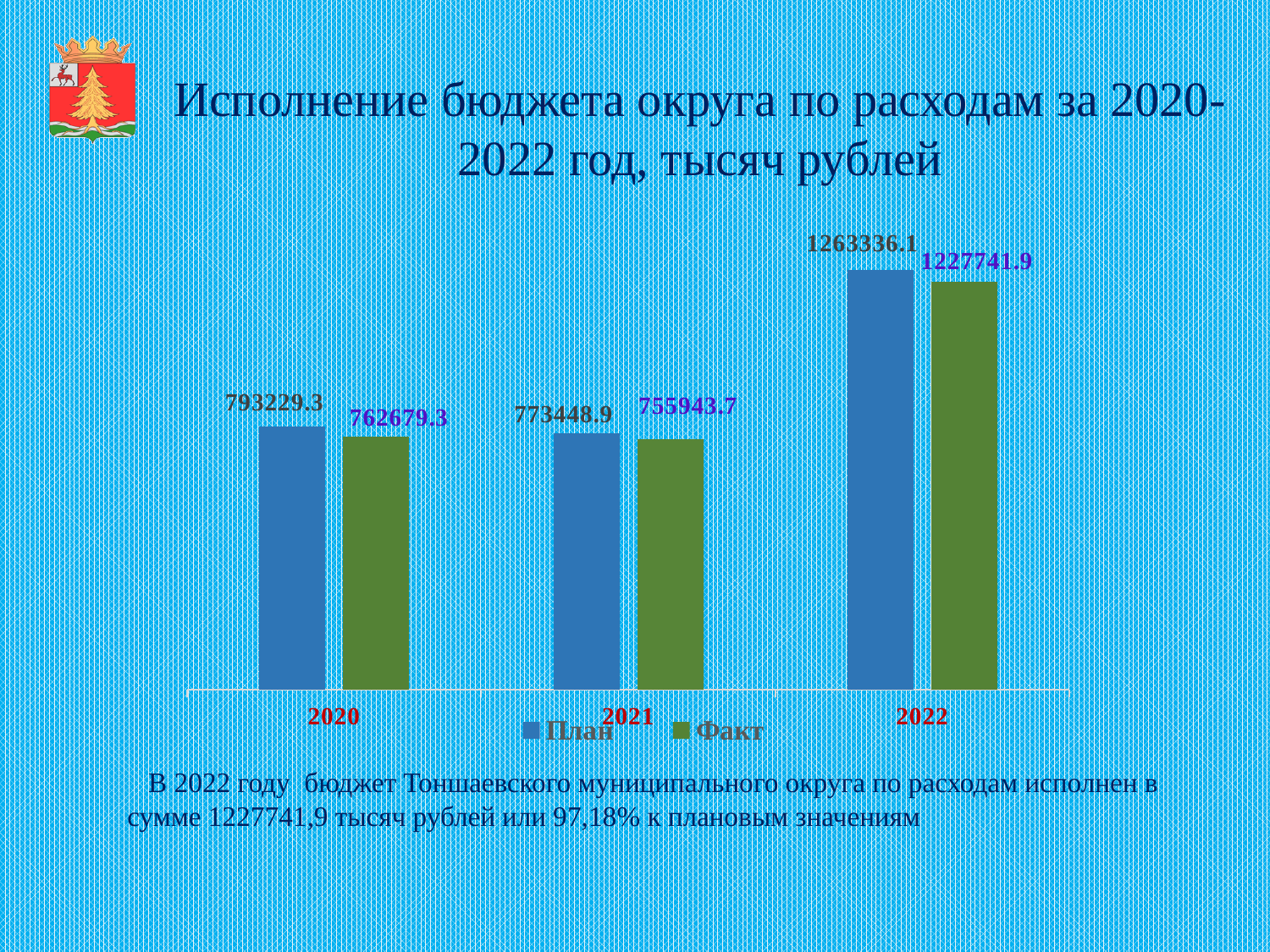
What is the План value for 2022? 1263336.1 Which year has the highest Факт value? 2022 What is the difference between the План and Факт values for 2020? 30550.0 What kind of chart is shown on the slide? bar chart What is the Факт value for 2021? 755943.7 How many years are shown on the x axis? 3 Which is larger, the План value for 2020 or the План value for 2021? План value for 2020 Which year has the lowest План value? 2021 How many series does the legend list? 2 What is the План value for 2021? 773448.9 What is the difference between the План and Факт values for 2022? 35594.2 What is the Факт value for 2020? 762679.3